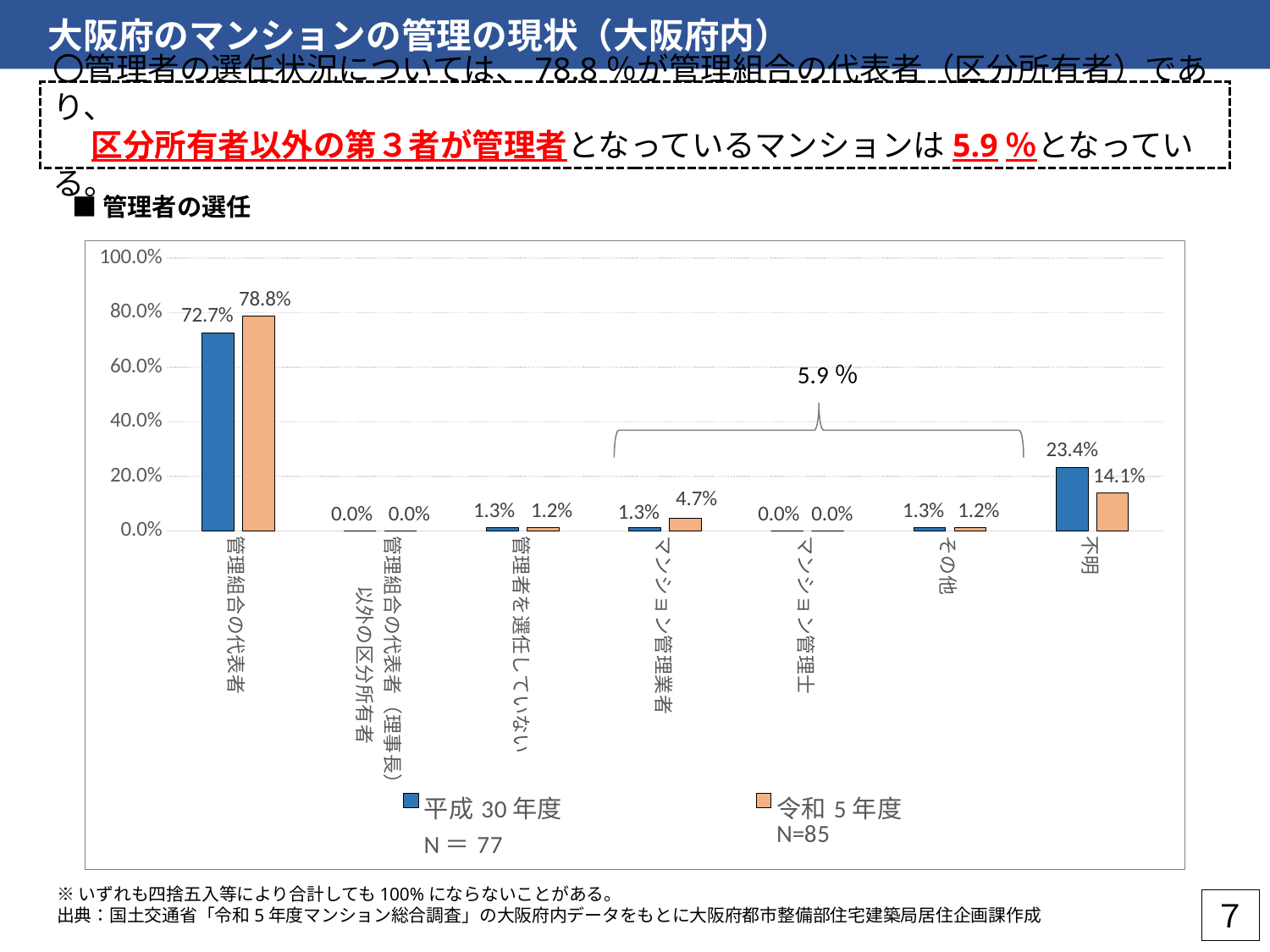
「管理者の選任」のグラフはどの種類のグラフですか？ 棒グラフ 「管理者の選任」のグラフで、「管理組合の代表者」の令和5年度と平成30年度の差はいくつですか？ 6.1% 「管理者の選任」のグラフの凡例には、いくつの系列がありますか？ 2 「管理者の選任」のグラフには、いくつのカテゴリがありますか？ 7 「管理者の選任」のグラフで、「不明」の平成30年度と令和5年度の差はいくつですか？ 9.3% 「管理者の選任」のグラフで、「マンション管理業者」は平成30年度と令和5年度のどちらが大きいですか？ 令和5年度 「管理者の選任」のグラフで、「不明」は平成30年度と令和5年度のどちらが大きいですか？ 平成30年度 「管理者の選任」のグラフで、令和5年度の「マンション管理業者」の値はいくつですか？ 4.7% 「管理者の選任」のグラフで、令和5年度の系列のNはいくつですか？ N=85 「管理者の選任」のグラフで、平成30年度の「不明」の値はいくつですか？ 23.4% 「管理者の選任」のグラフで、令和5年度の値が最も高いカテゴリはどれですか？ 管理組合の代表者 「管理者の選任」のグラフで、令和5年度の「管理組合の代表者」の値はいくつですか？ 78.8%